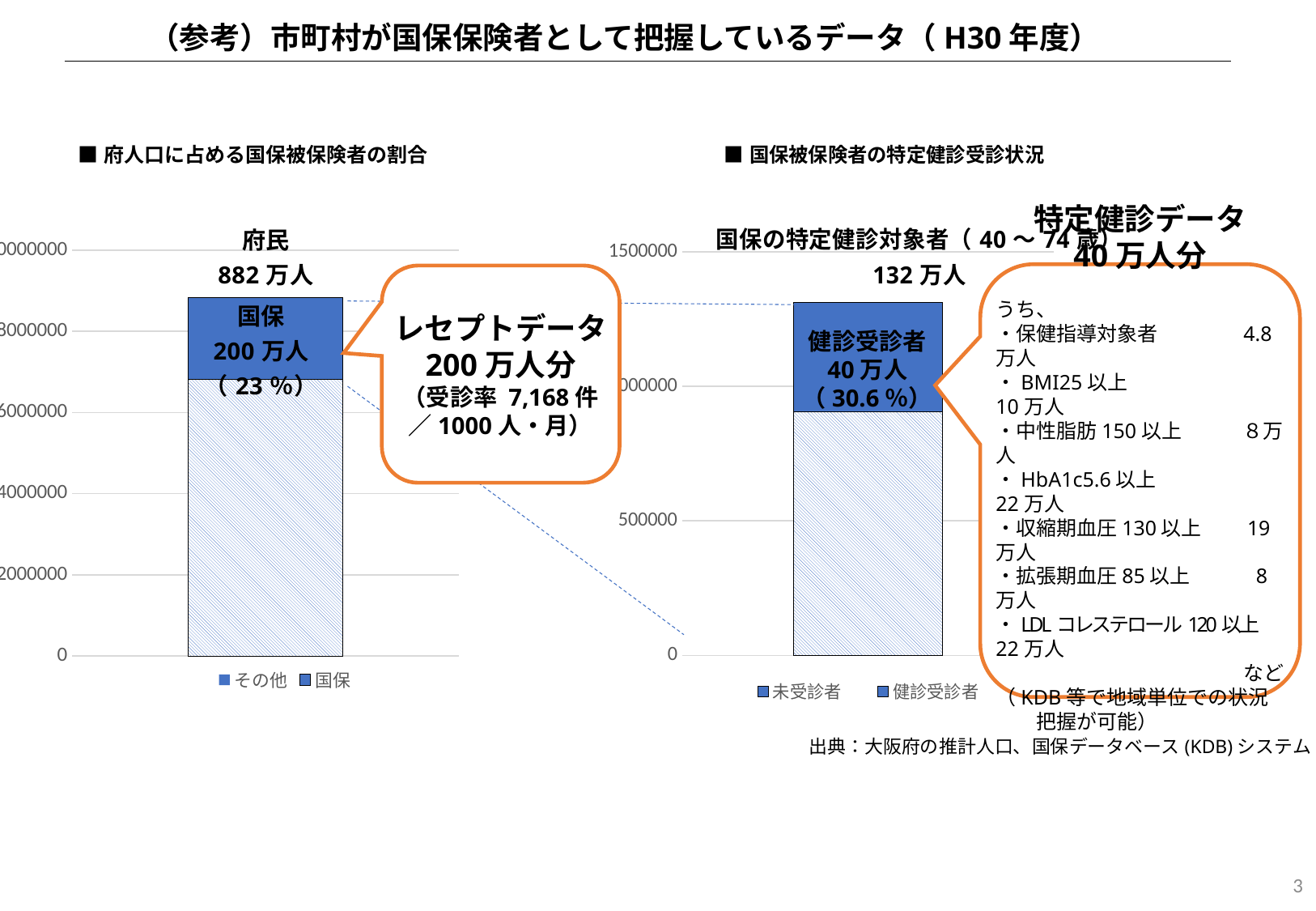
On the left chart (府人口に占める国保被保険者の割合), how many series does the legend list? 2 On the right chart (国保被保険者の特定健診受診状況), what are the two legend entries? 未受診者, 健診受診者 On the left chart (府人口に占める国保被保険者の割合), what is the difference between the 府民 total (882万人) and the 国保 segment (200万人)? 682万人 On the left chart (府人口に占める国保被保険者の割合), what percentage of 府民 does the 国保 segment represent? 23% What type of chart is used on the left chart (府人口に占める国保被保険者の割合)? stacked bar chart On the right chart (国保被保険者の特定健診受診状況), what percentage of the 特定健診対象者 are 健診受診者? 30.6% On the right chart (国保被保険者の特定健診受診状況), what is the difference between the 特定健診対象者 total (132万人) and the 健診受診者 (40万人)? 92万人 Which is larger: the 国保 segment on the left chart (200万人) or the 健診受診者 segment on the right chart (40万人)? 国保 (200万人) On the right chart (国保被保険者の特定健診受診状況), how many 国保の特定健診対象者 (40～74歳) are shown above the bar? 132万人 On the left chart (府人口に占める国保被保険者の割合), what is the total number of 府民 shown above the bar? 882万人 On the right chart (国保被保険者の特定健診受診状況), how many 健診受診者 are shown? 40万人 On the left chart (府人口に占める国保被保険者の割合), how many people are in the 国保 segment? 200万人